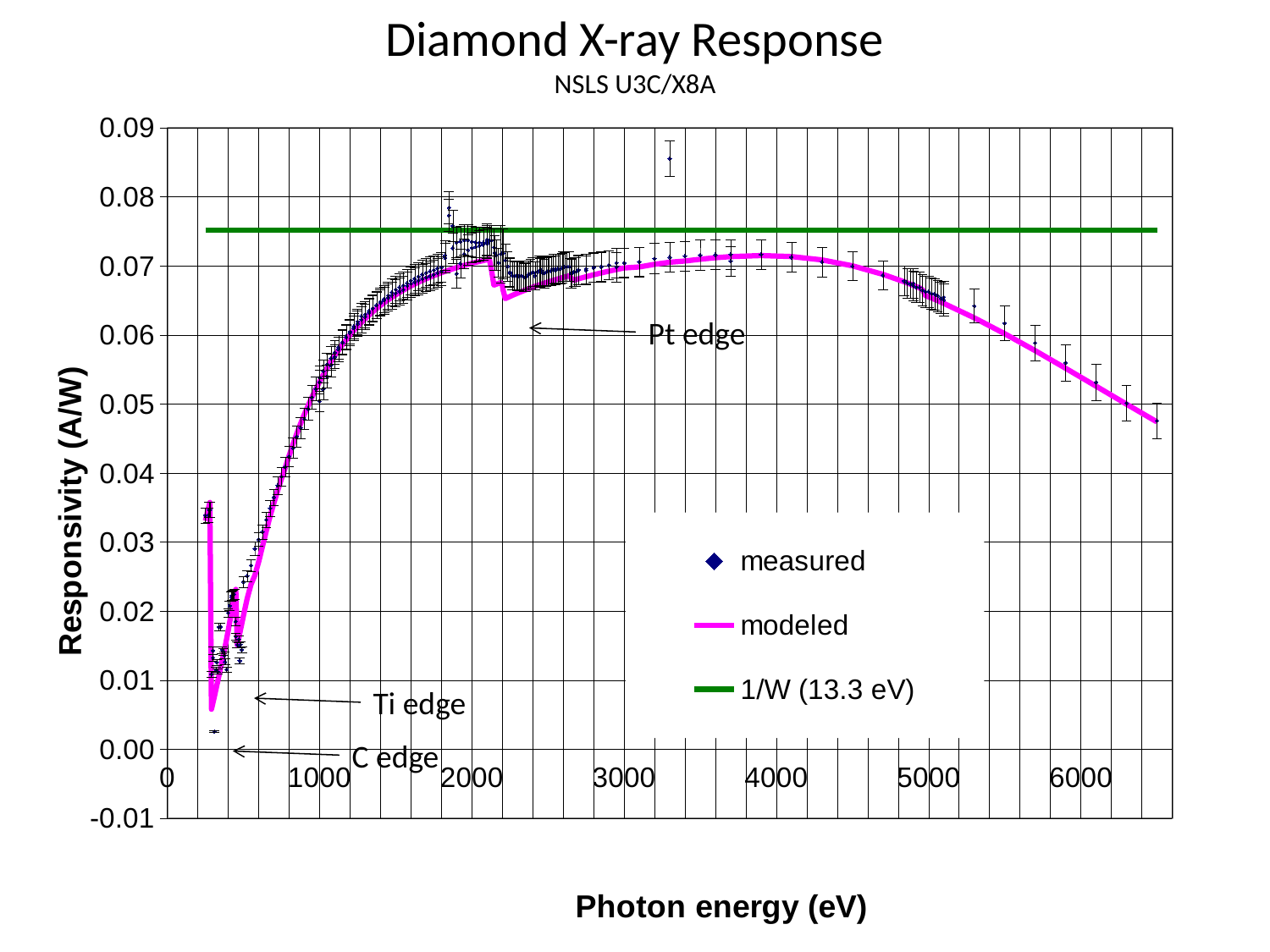
Is the modeled responsivity at 1000 eV greater or less than 0.03 A/W? greater What label is given to the horizontal green line in the legend? 1/W (13.3 eV) Which is higher: the modeled responsivity at 3000 eV or at 6000 eV? 3000 eV What kind of chart is shown on the slide? line chart Is the 1/W (13.3 eV) line greater or less than 0.07 A/W? greater Does the modeled responsivity rise or fall as photon energy increases from 4000 eV to 6000 eV? fall What is the title of the chart? Diamond X-ray Response Does the modeled responsivity rise or fall as photon energy increases from 500 eV to 1500 eV? rise How many series does the legend list? 3 Is the modeled responsivity at 2000 eV greater or less than 0.06 A/W? greater At 4000 eV, which is higher: the 1/W (13.3 eV) line or the modeled curve? 1/W (13.3 eV) line